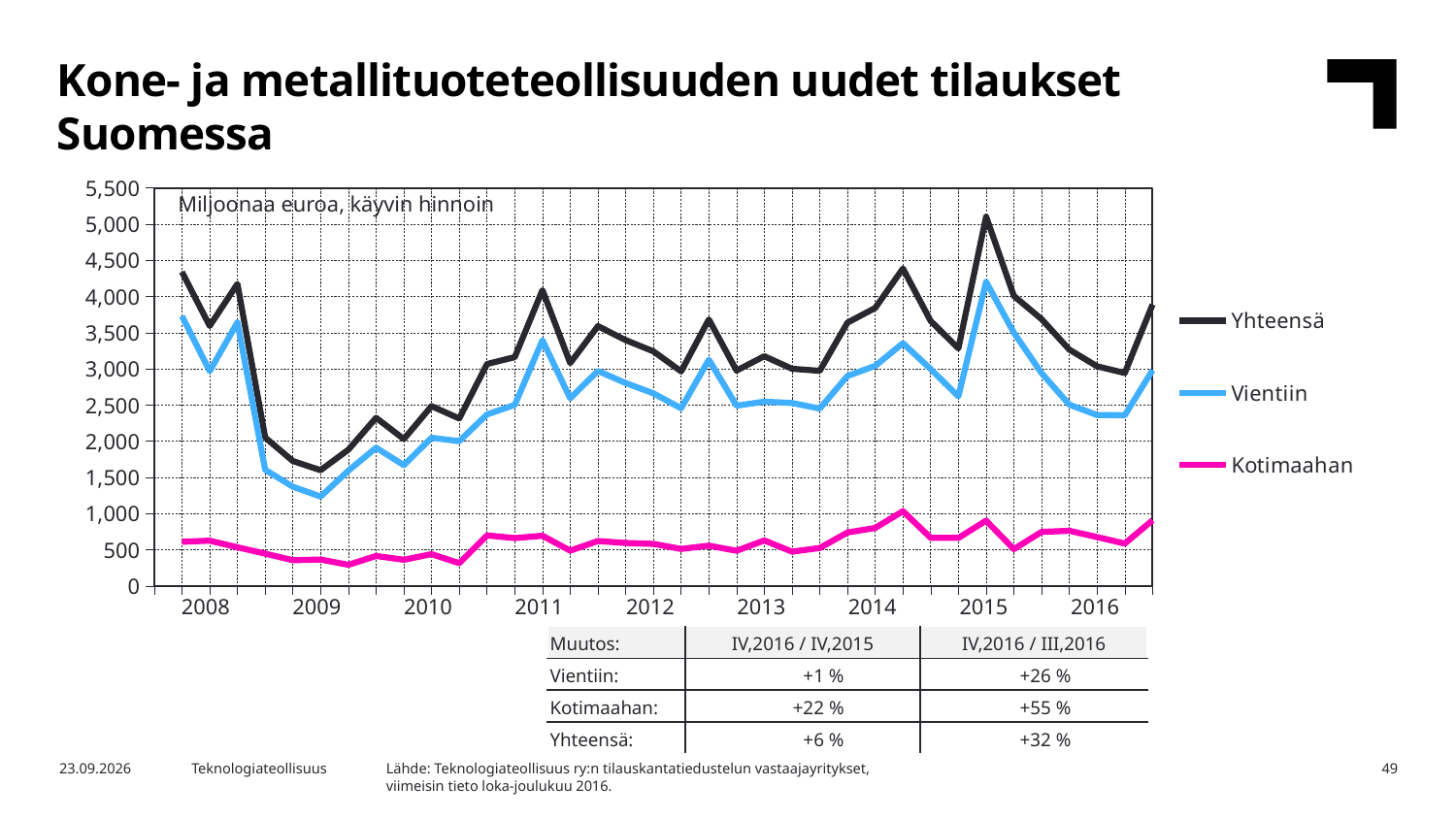
Is the peak value of Yhteensä in 2015 greater or less than 4,500? greater Is the highest value of Kotimaahan greater or less than 1,500? less Does the Yhteensä series rise or fall from the start of 2008 to 2009? fall In which year does the Yhteensä series reach its highest value? 2015 At the 2015 peak, which series is higher, Yhteensä or Vientiin? Yhteensä What kind of chart is shown on the slide? line chart Is the lowest value of Vientiin in 2009 greater or less than 1,500? less Which series has the lowest values across the whole chart? Kotimaahan What are the three series named in the legend? Yhteensä, Vientiin, Kotimaahan How many series does the legend list? 3 Does the Vientiin series rise or fall from 2009 to 2011? rise What unit label is printed inside the plot area? Miljoonaa euroa, käyvin hinnoin